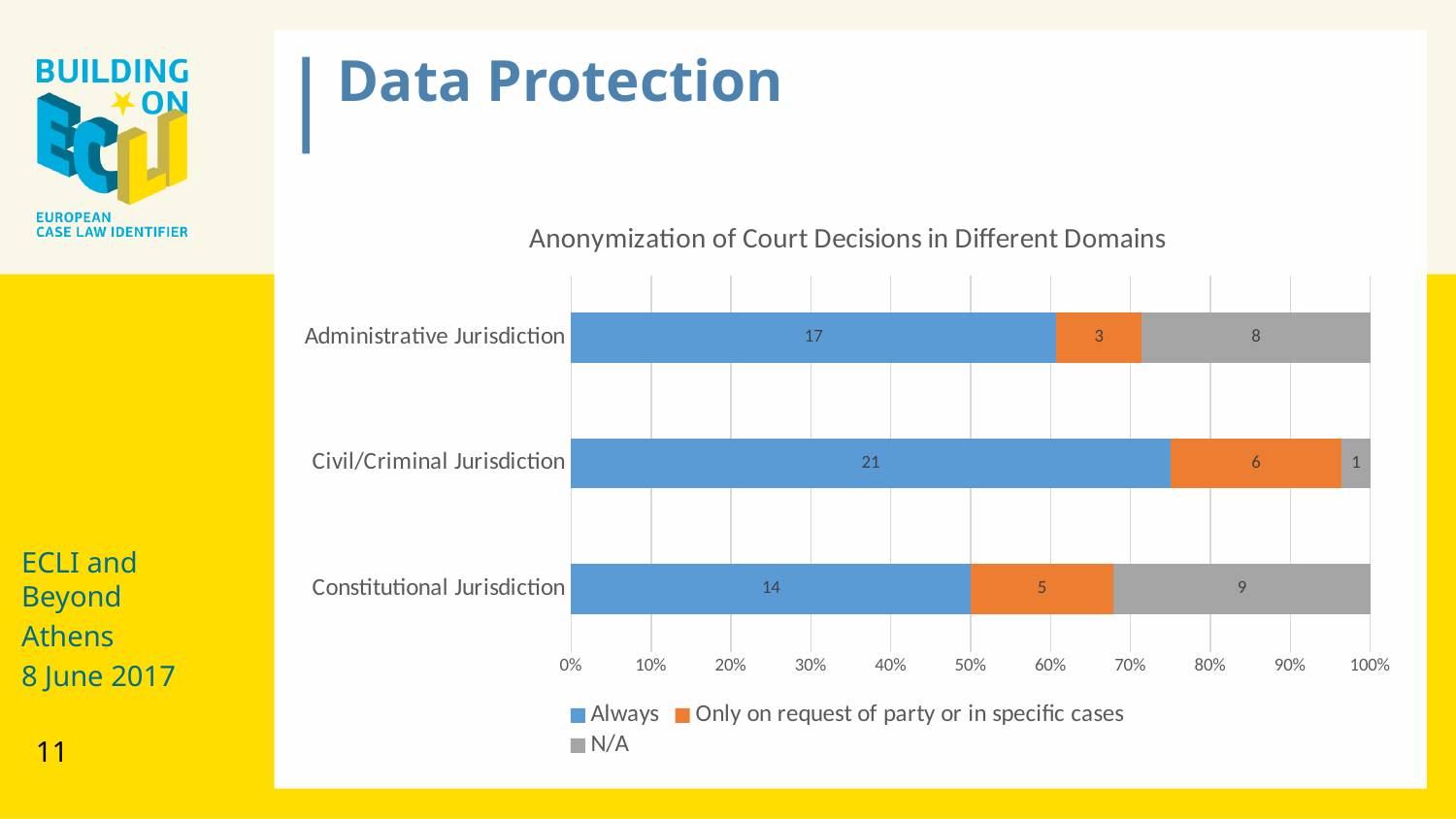
What is the value for "Only on request of party or in specific cases" in Administrative Jurisdiction? 3 How many series does the legend list? 3 What is the difference between the "Always" values for Civil/Criminal Jurisdiction and Constitutional Jurisdiction? 7 Which jurisdiction has the lowest value for "N/A"? Civil/Criminal Jurisdiction Which jurisdiction has the highest value for "Always"? Civil/Criminal Jurisdiction Which is larger: the "N/A" value for Administrative Jurisdiction or for Constitutional Jurisdiction? Constitutional Jurisdiction What is the value for "N/A" in Constitutional Jurisdiction? 9 What is the value for "Always" in Civil/Criminal Jurisdiction? 21 What kind of chart is shown on the slide? Stacked bar chart How many jurisdiction categories are shown in the chart? 3 What is the title of the chart? Anonymization of Court Decisions in Different Domains What is the total of the three values in the Administrative Jurisdiction bar? 28